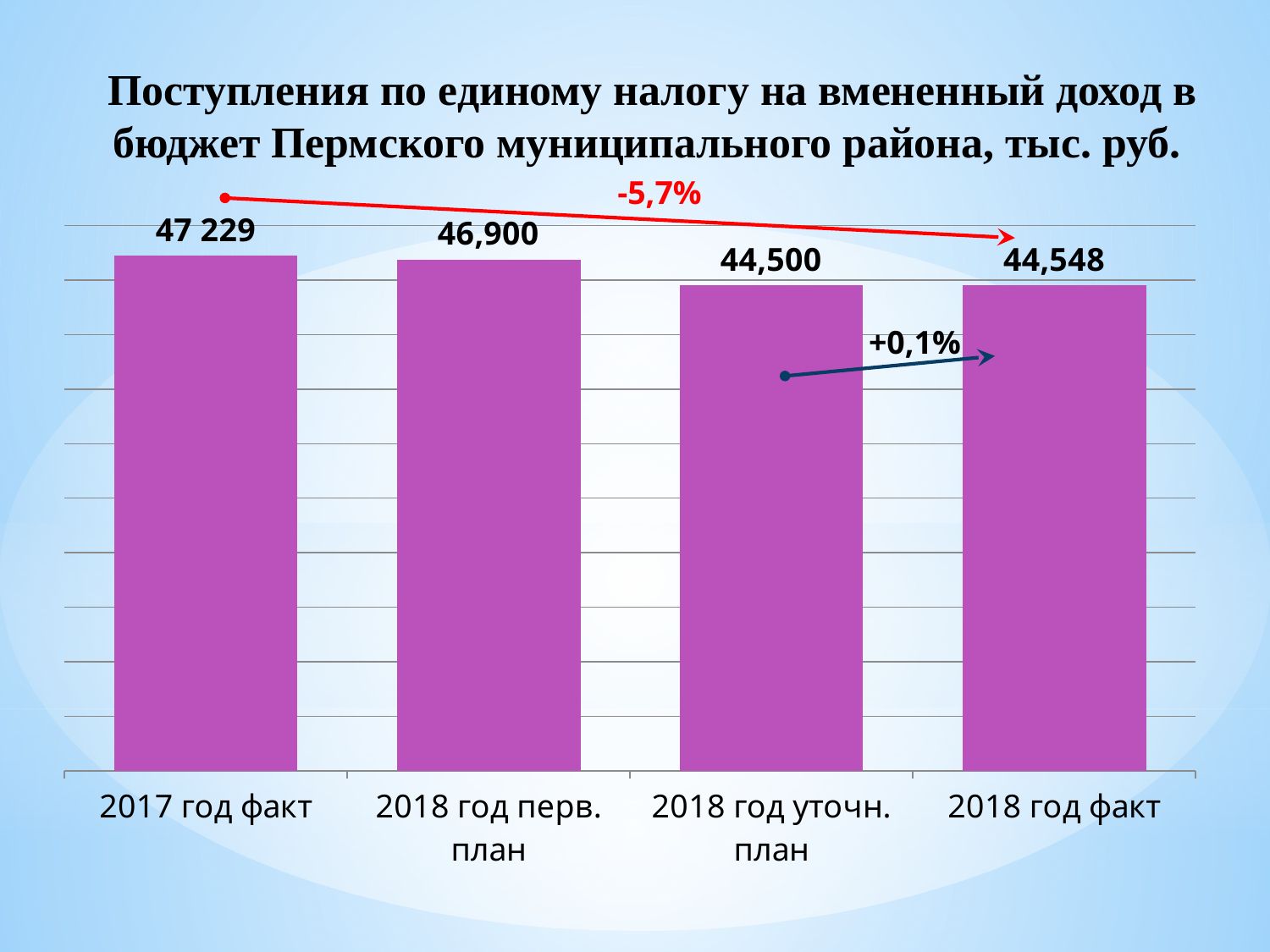
What is the difference between 2018 год факт and 2018 год уточн. план? 48 What is the difference between 2018 год перв. план and 2018 год уточн. план? 2,400 Which category has the highest value? 2017 год факт How many categories are shown on the chart? 4 Which category has the lowest value? 2018 год уточн. план What kind of chart is this? bar chart What is the value for 2018 год перв. план? 46,900 What is the value for 2018 год уточн. план? 44,500 What is the value for 2018 год факт? 44,548 Which is larger, 2017 год факт or 2018 год факт? 2017 год факт What percentage change is shown by the red arrow from 2017 год факт to 2018 год факт? -5,7% What is the value for 2017 год факт? 47 229